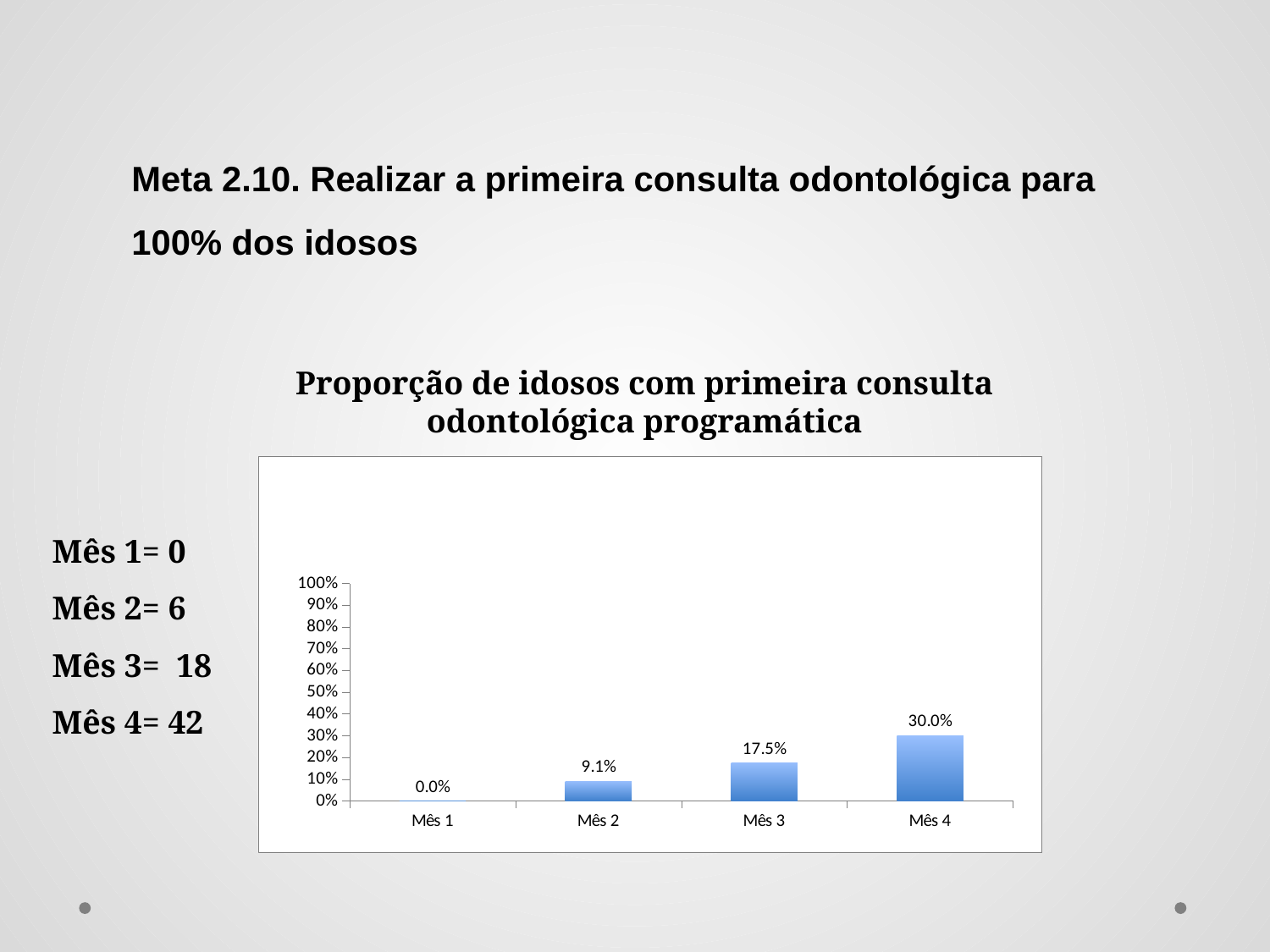
Which month has the lowest proportion? Mês 1 How many months are shown on the x axis? 4 Do the values rise or fall from Mês 1 to Mês 4? rise What is the value for Mês 4? 30.0% What is the value for Mês 1? 0.0% Which is larger, the value for Mês 2 or the value for Mês 3? Mês 3 What is the value for Mês 3? 17.5% Which month has the highest proportion? Mês 4 What is the difference between the values for Mês 4 and Mês 3? 12.5% Is the value for Mês 4 greater or less than 50%? less What is the value for Mês 2? 9.1% What kind of chart is shown? bar chart